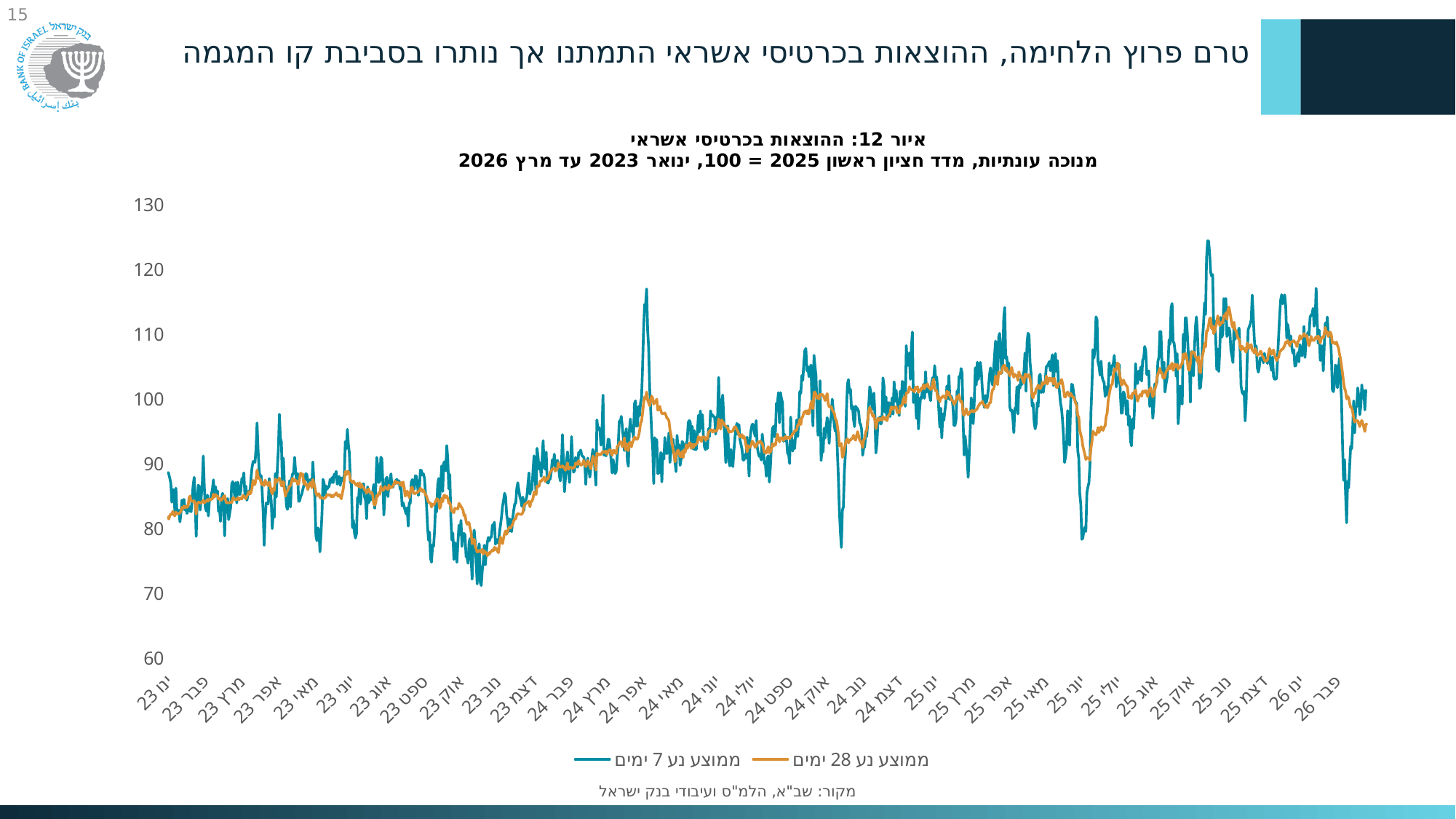
Is the 28-day moving average (ממוצע נע 28 ימים) at the end of the series, after פבר 26, greater or less than 100? less What kind of chart is shown on the slide? line chart Is the 28-day moving average (ממוצע נע 28 ימים) at its peak around נוב 25 greater or less than 110? greater How many series does the legend list? 2 Does the 28-day moving average (ממוצע נע 28 ימים) rise or fall between נוב 23 and נוב 25? rise Is the lowest point of the 7-day moving average (ממוצע נע 7 ימים), around נוב 23, greater or less than 80? less Which series shows larger short-term swings, the 7-day moving average or the 28-day moving average? ממוצע נע 7 ימים Does the 28-day moving average (ממוצע נע 28 ימים) rise or fall between נוב 25 and the end of the series in 2026? fall What is the base period of the index according to the chart subtitle? מדד חציון ראשון 2025 = 100 What are the two series named in the legend? ממוצע נע 7 ימים and ממוצע נע 28 ימים